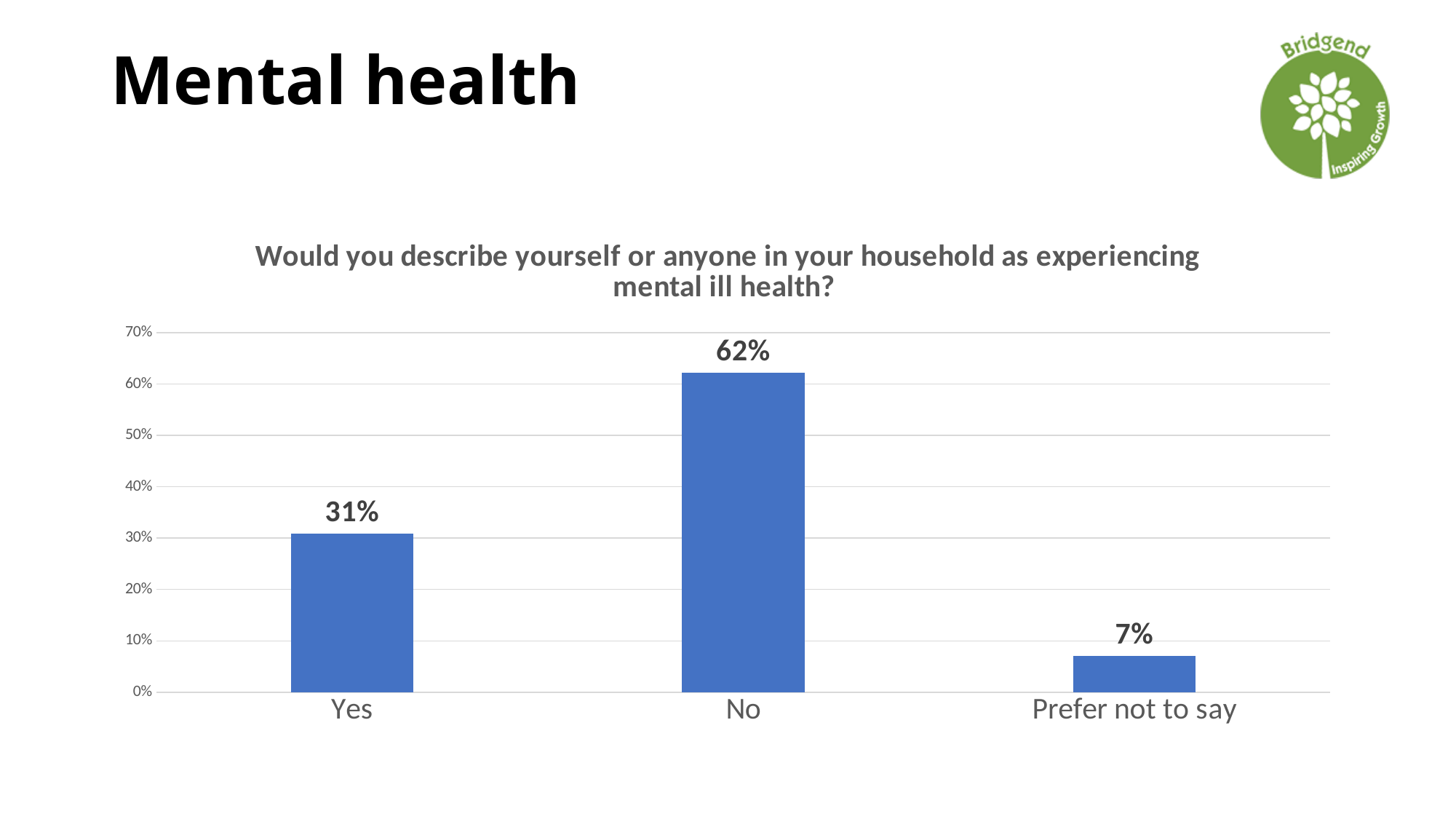
What is the difference in percentage points between the "No" and "Yes" responses? 31 What percentage of respondents answered "Yes"? 31% What percentage of respondents answered "No"? 62% What type of chart is shown on the slide? Bar chart Which response category has the lowest value? Prefer not to say Which is larger, the value for "Yes" or the value for "Prefer not to say"? Yes What is the title of the chart? Would you describe yourself or anyone in your household as experiencing mental ill health? Is the value for "No" greater or less than 50%? greater What percentage of respondents answered "Prefer not to say"? 7% Which response category has the highest value? No How many response categories are shown on the chart? 3 What is the difference in percentage points between the "Yes" and "Prefer not to say" responses? 24